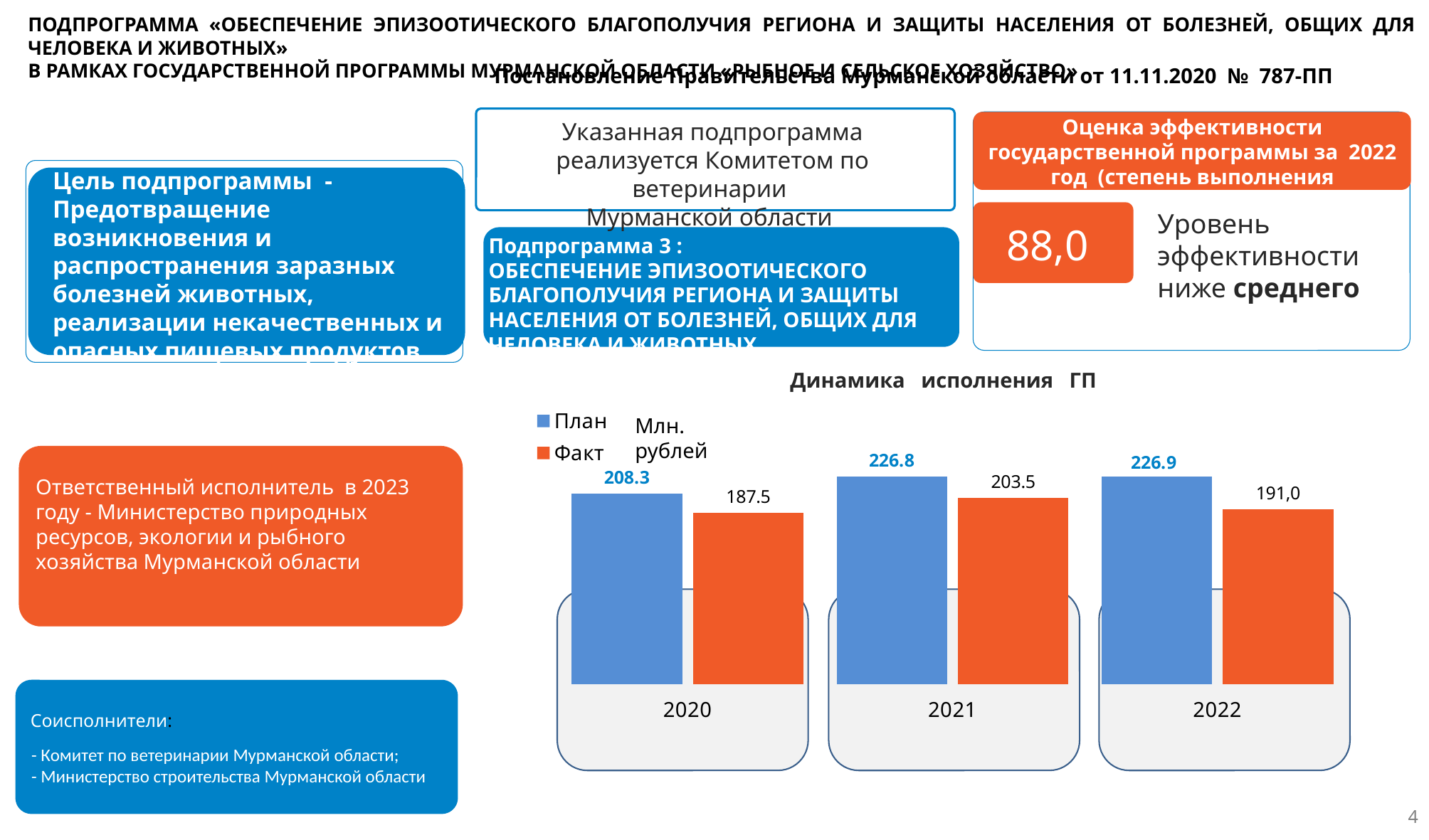
What is the План value for 2022 in the chart «Динамика исполнения ГП»? 226.9 In which year is the Факт value highest in the chart «Динамика исполнения ГП»? 2021 Which is larger in the chart «Динамика исполнения ГП»: Факт for 2021 or Факт for 2020? Факт for 2021 In which year is the План value lowest in the chart «Динамика исполнения ГП»? 2020 What is the difference between План and Факт for 2020 in the chart «Динамика исполнения ГП»? 20.8 What is the difference between План and Факт for 2022 in the chart «Динамика исполнения ГП»? 35.9 What is the План value for 2020 in the chart «Динамика исполнения ГП»? 208.3 How many series does the legend of the chart «Динамика исполнения ГП» list? 2 What type of chart is «Динамика исполнения ГП»? Bar chart How many years are shown on the x axis of the chart «Динамика исполнения ГП»? 3 What is the Факт value for 2022 in the chart «Динамика исполнения ГП»? 191,0 What is the Факт value for 2021 in the chart «Динамика исполнения ГП»? 203.5